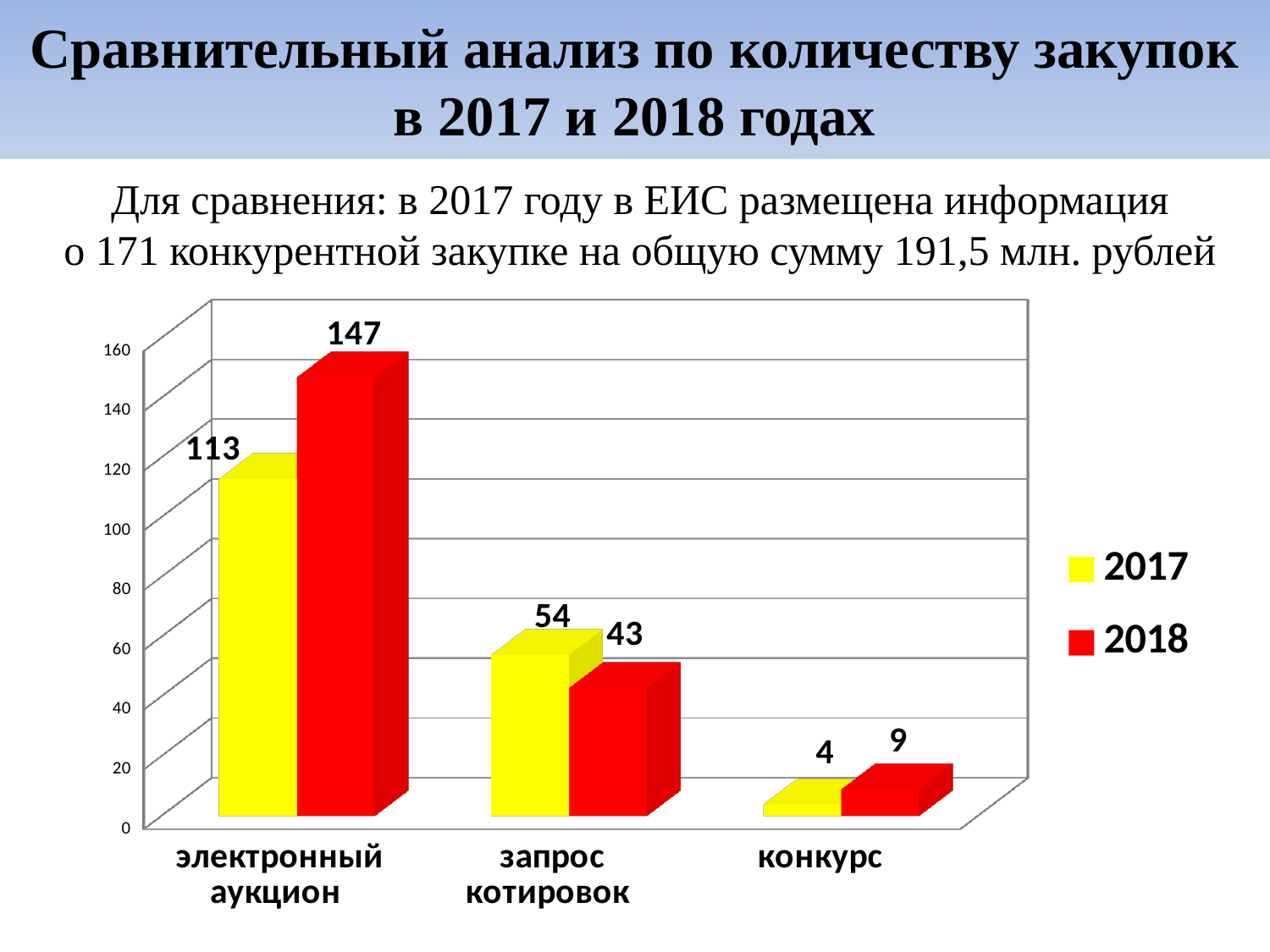
What is the value for электронный аукцион in 2018? 147 Which is larger for конкурс: the 2017 value or the 2018 value? 2018 Which category has the lowest value in 2017? конкурс What is the value for запрос котировок in 2018? 43 What kind of chart is shown on the slide? bar chart How many series does the legend list? 2 What is the value for конкурс in 2017? 4 Which category has the highest value in 2018? электронный аукцион What is the value for электронный аукцион in 2017? 113 What is the difference between the 2018 and 2017 values for электронный аукцион? 34 How many categories are shown on the x axis? 3 What is the difference between the 2017 and 2018 values for запрос котировок? 11